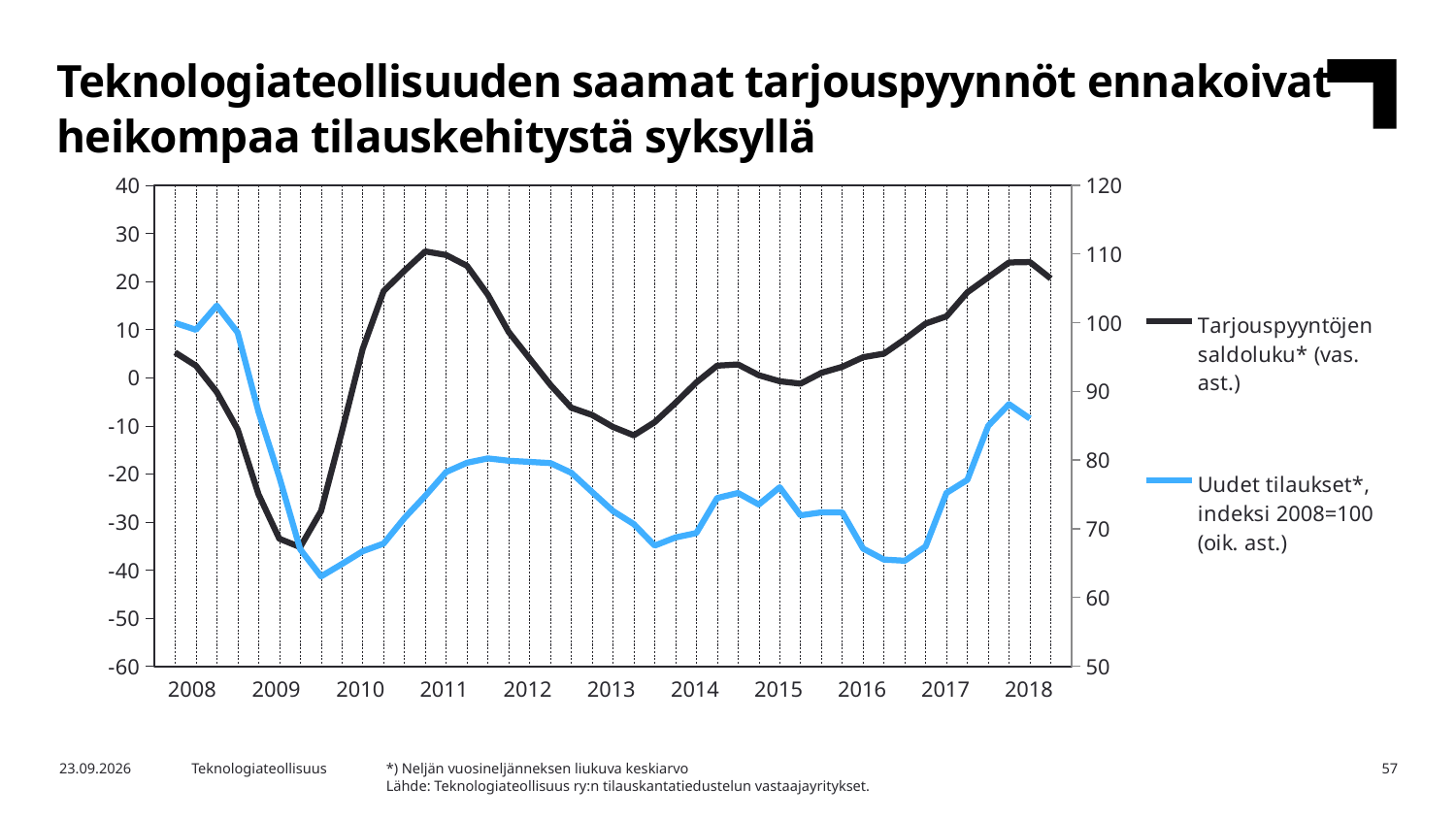
In which year does the Tarjouspyyntöjen saldoluku* line reach its lowest point? 2009 Is the value of the Uudet tilaukset* index at the end of 2018 greater or less than 80? greater Does the Tarjouspyyntöjen saldoluku* line rise or fall between 2011 and 2013? fall What colour is the line for Tarjouspyyntöjen saldoluku*? black How many year labels are shown on the x axis? 11 Is the peak value of the Tarjouspyyntöjen saldoluku* line around 2011 greater or less than 20? greater What kind of chart is shown on the slide? line chart Which is larger for the Uudet tilaukset* index: the value in 2008 or the value in 2016? 2008 Which series is plotted on the right-hand axis (oik. ast.)? Uudet tilaukset*, indeksi 2008=100 Is the lowest value of the Tarjouspyyntöjen saldoluku* line around 2009 greater or less than -30? less How many series does the legend list? 2